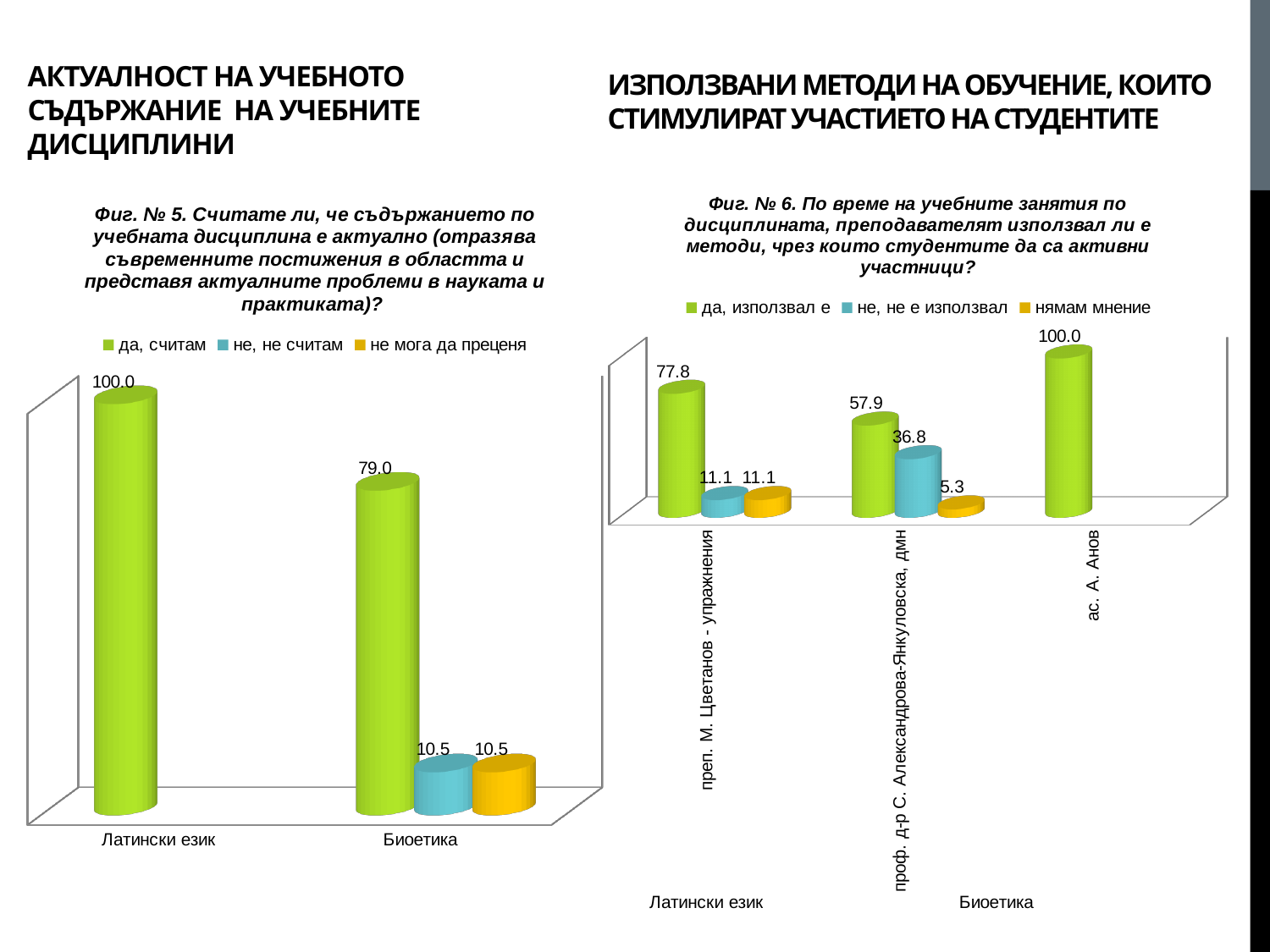
In the right chart (Фиг. № 6), which lecturer has the highest "да, използвал е" value? ас. А. Анов In the right chart (Фиг. № 6), what is the value of "да, използвал е" for преп. М. Цветанов - упражнения? 77.8 What type of chart is the right chart (Фиг. № 6)? bar chart In the right chart (Фиг. № 6), how many lecturers are shown on the x axis? 3 In the right chart (Фиг. № 6), what is the value of "не, не е използвал" for проф. д-р С. Александрова-Янкуловска, дмн? 36.8 In the left chart (Фиг. № 5), how many series does the legend list? 3 In the right chart (Фиг. № 6), what is the value of "нямам мнение" for проф. д-р С. Александрова-Янкуловска, дмн? 5.3 In the left chart (Фиг. № 5), what is the value of "да, считам" for Биоетика? 79.0 In the right chart (Фиг. № 6), which lecturer has the lowest "да, използвал е" value? проф. д-р С. Александрова-Янкуловска, дмн In the left chart (Фиг. № 5), what is the value of "да, считам" for Латински език? 100.0 In the left chart (Фиг. № 5), what is the difference between the "да, считам" values for Латински език and Биоетика? 21.0 In the left chart (Фиг. № 5), what is the value of "не, не считам" for Биоетика? 10.5